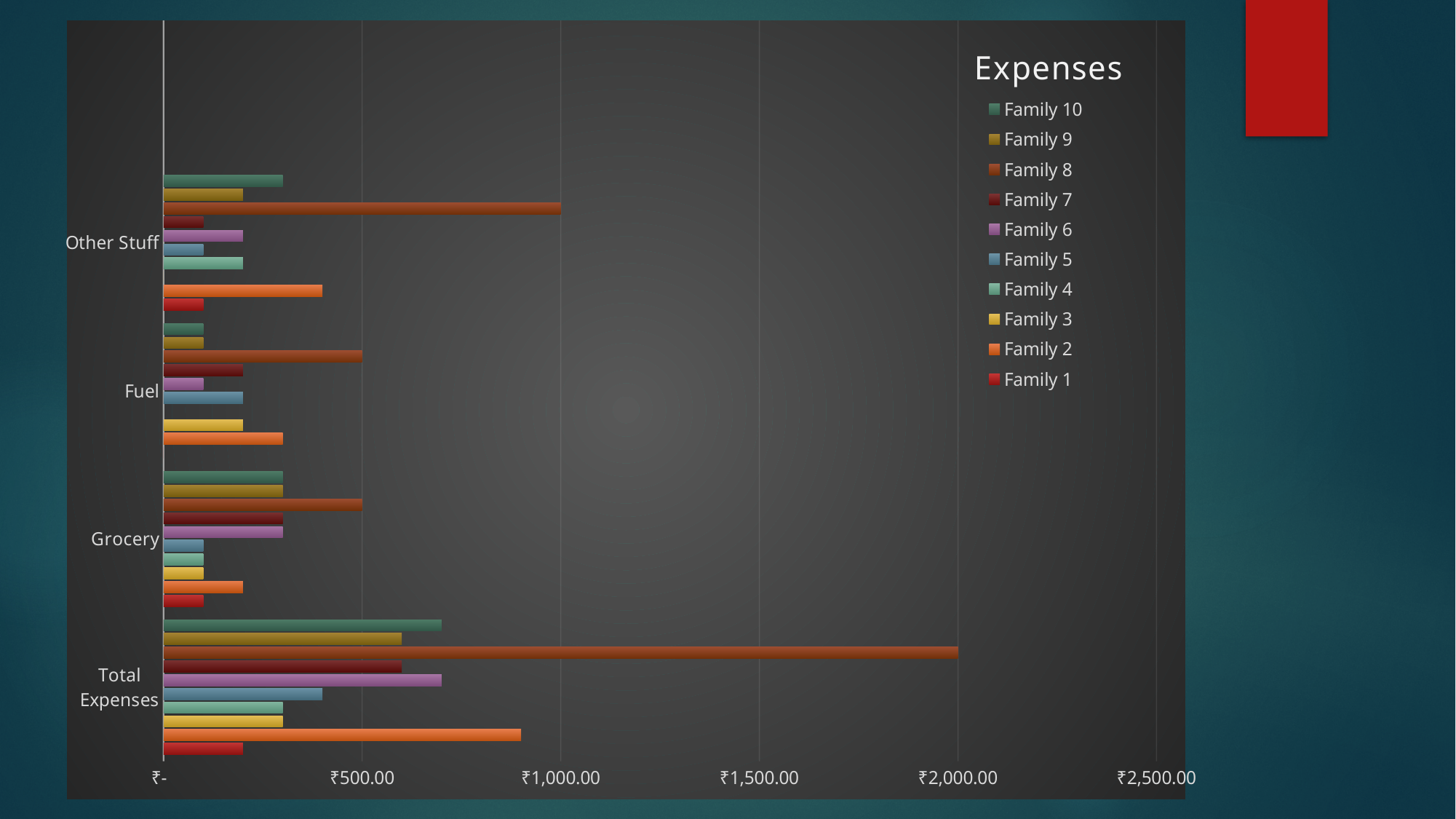
What is the Fuel value for Family 8? ₹500.00 What is the Total Expenses value for Family 8? ₹2,000.00 Which is larger in Total Expenses, Family 2 or Family 5? Family 2 What is the title of the chart? Expenses Is the Total Expenses value for Family 2 greater or less than ₹1,000.00? less What kind of chart is shown on the slide? bar chart Which family has the lowest Total Expenses? Family 1 What is the Other Stuff value for Family 8? ₹1,000.00 Which family has the highest Total Expenses? Family 8 Is the Total Expenses value for Family 10 greater or less than ₹500.00? greater How many series does the legend list? 10 How many categories are shown on the vertical axis? 4